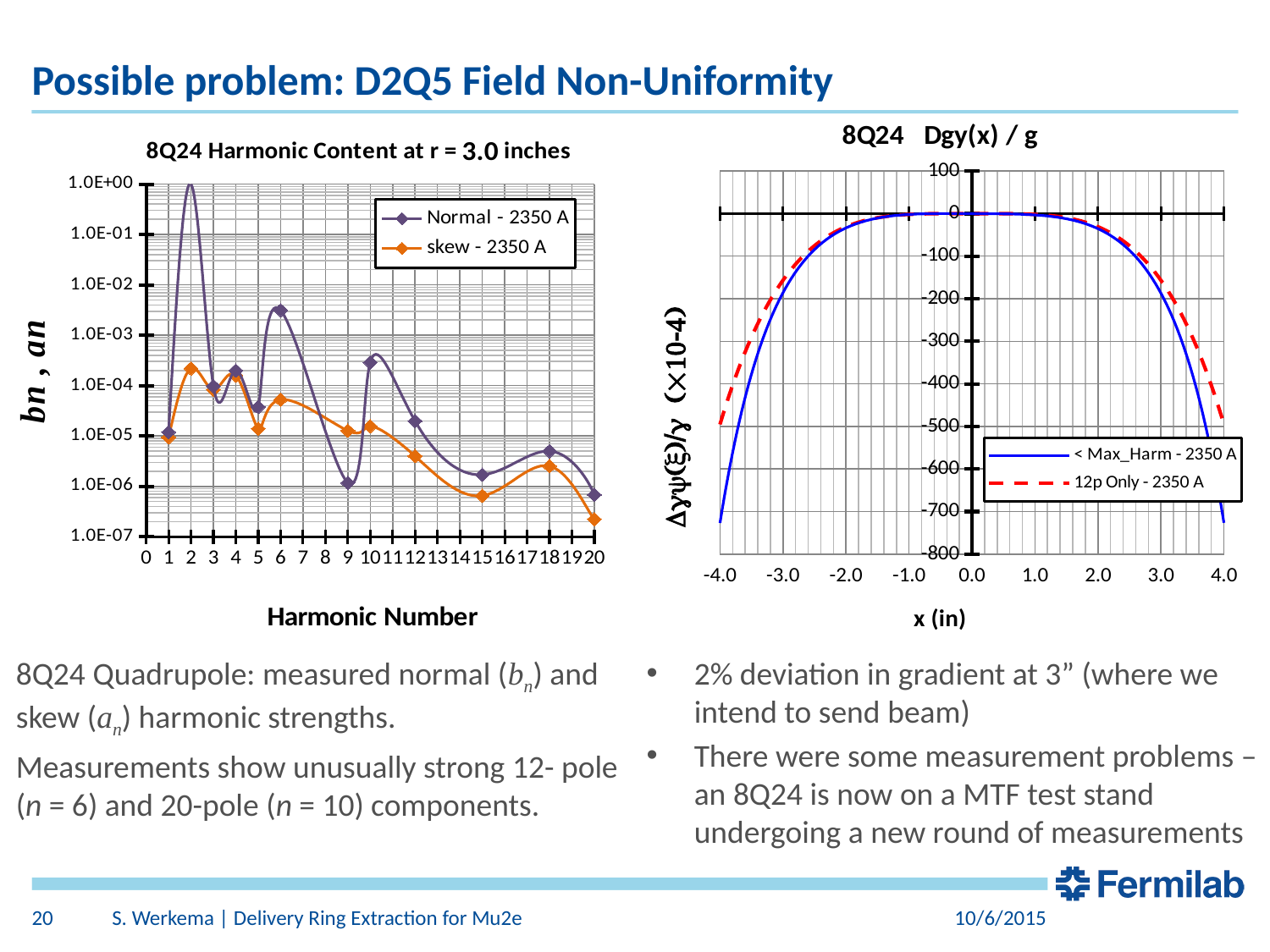
On the chart titled "8Q24 Dgy(x) / g", is the value of the < Max_Harm - 2350 A series at x = 4.0 greater or less than -600? less On the chart titled "8Q24 Dgy(x) / g", is the value of the 12p Only - 2350 A series at x = 4.0 greater or less than -600? greater On the chart titled "8Q24 Harmonic Content at r = 3.0 inches", what is the label of the x axis? Harmonic Number On the chart titled "8Q24 Harmonic Content at r = 3.0 inches", how many series does the legend list? 2 On the chart titled "8Q24 Harmonic Content at r = 3.0 inches", at which harmonic number does the Normal - 2350 A series reach its highest value? 2 On the chart titled "8Q24 Harmonic Content at r = 3.0 inches", which series has the larger value at harmonic number 10, Normal - 2350 A or skew - 2350 A? Normal - 2350 A On the chart titled "8Q24 Harmonic Content at r = 3.0 inches", is the Normal - 2350 A value at harmonic number 6 greater or less than 1.0E-03? greater On the chart titled "8Q24 Dgy(x) / g", do the values rise or fall as x increases from 0.0 to 4.0? fall What kind of chart is the chart titled "8Q24 Dgy(x) / g"? line chart On the chart titled "8Q24 Harmonic Content at r = 3.0 inches", what are the two legend entries? Normal - 2350 A and skew - 2350 A On the chart titled "8Q24 Dgy(x) / g", how many series does the legend list? 2